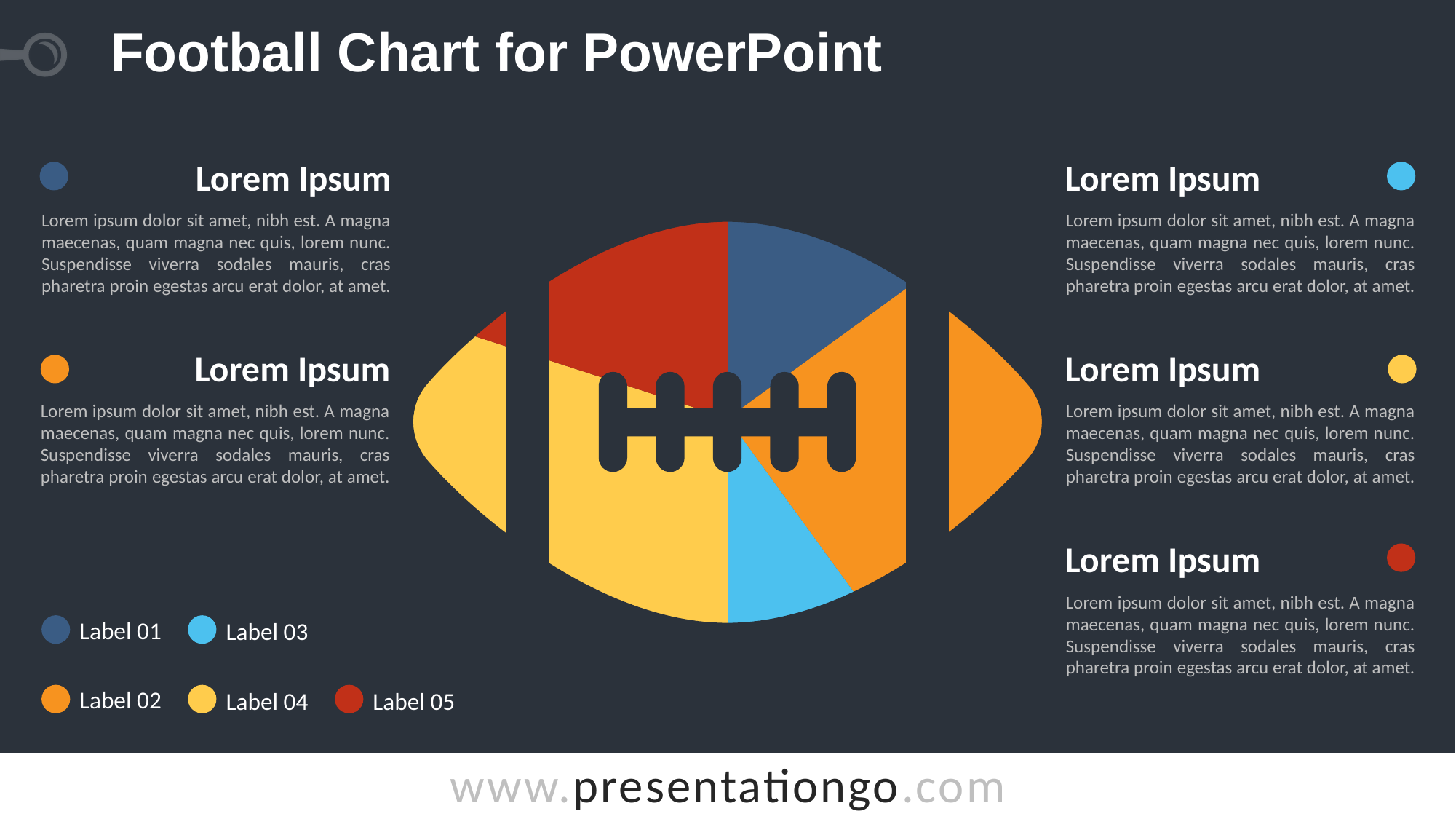
What is the title of the slide containing the chart? Football Chart for PowerPoint What colour represents Label 05 in the chart legend? Red How many categories does the legend of the chart list? 5 Which category has the smallest slice in the pie chart? Label 03 Which slice is larger in the pie chart, Label 01 or Label 03? Label 01 Which slice is larger in the pie chart, Label 03 or Label 05? Label 05 What kind of chart is shown on the slide? Pie chart Which slice is larger in the pie chart, Label 03 or Label 04? Label 04